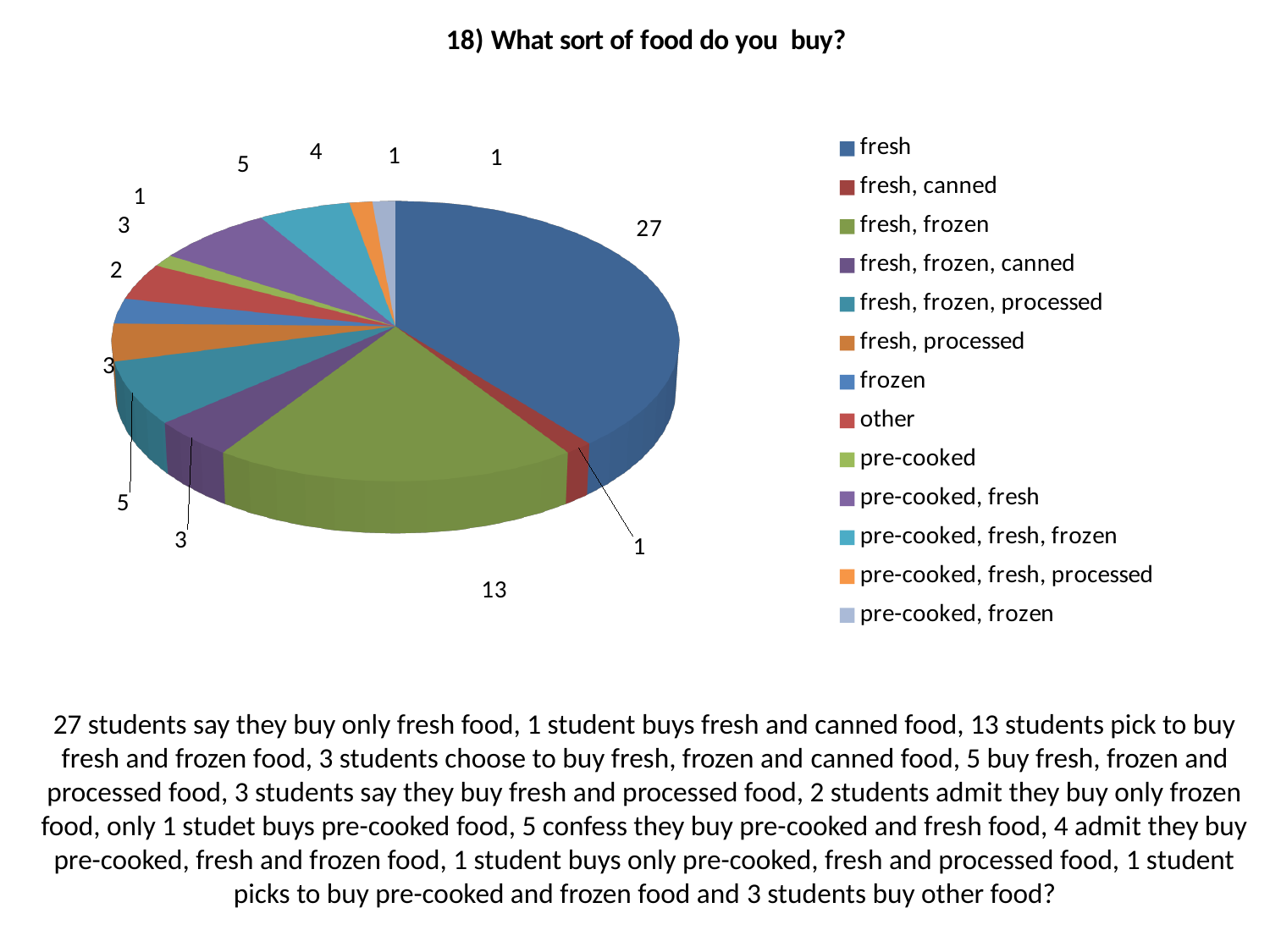
What colour is the 'fresh' slice in the chart? blue What type of chart is shown on the slide? pie chart What is the value for the 'fresh, frozen' slice? 13 Which category has the largest slice of the pie? fresh What is the total of all the values shown on the pie chart? 69 What is the difference between the 'fresh' value and the 'fresh, frozen' value? 14 What is the value for the 'frozen' slice? 2 Which is larger, the 'pre-cooked, fresh' slice or the 'pre-cooked, fresh, frozen' slice? pre-cooked, fresh What is the value for the 'fresh, frozen, processed' slice? 5 What is the title of the chart? 18) What sort of food do you buy? How many categories does the legend list? 13 How many students buy only fresh food according to the chart? 27